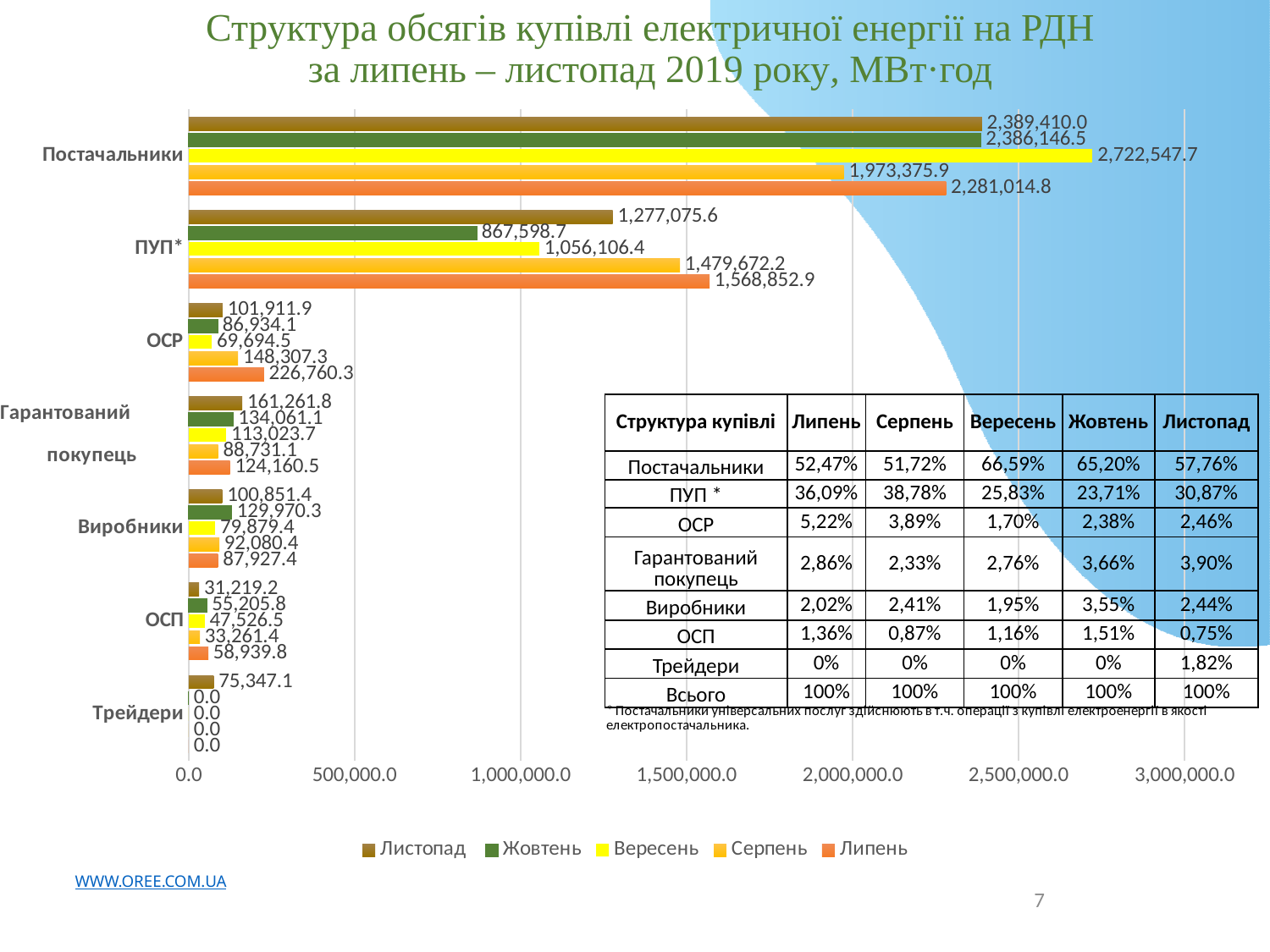
What is the difference between the Листопад and Серпень values for Гарантований покупець? 72,530.7 How many categories are shown on the chart's vertical axis? 7 What is the total of the Трейдери values across all five months? 75,347.1 What is the value for ПУП* in the Липень series? 1,568,852.9 What is the value for Виробники in the Жовтень series? 129,970.3 How many series does the chart legend list? 5 What is the value for Постачальники in the Вересень series? 2,722,547.7 What is the difference between the Листопад and Жовтень values for Постачальники? 3,263.5 What kind of chart is shown on the slide? Bar chart For ОСР, which is larger: the Липень value or the Серпень value? Липень Which month has the lowest value for ОСП? Листопад Which month has the highest value for Постачальники? Вересень